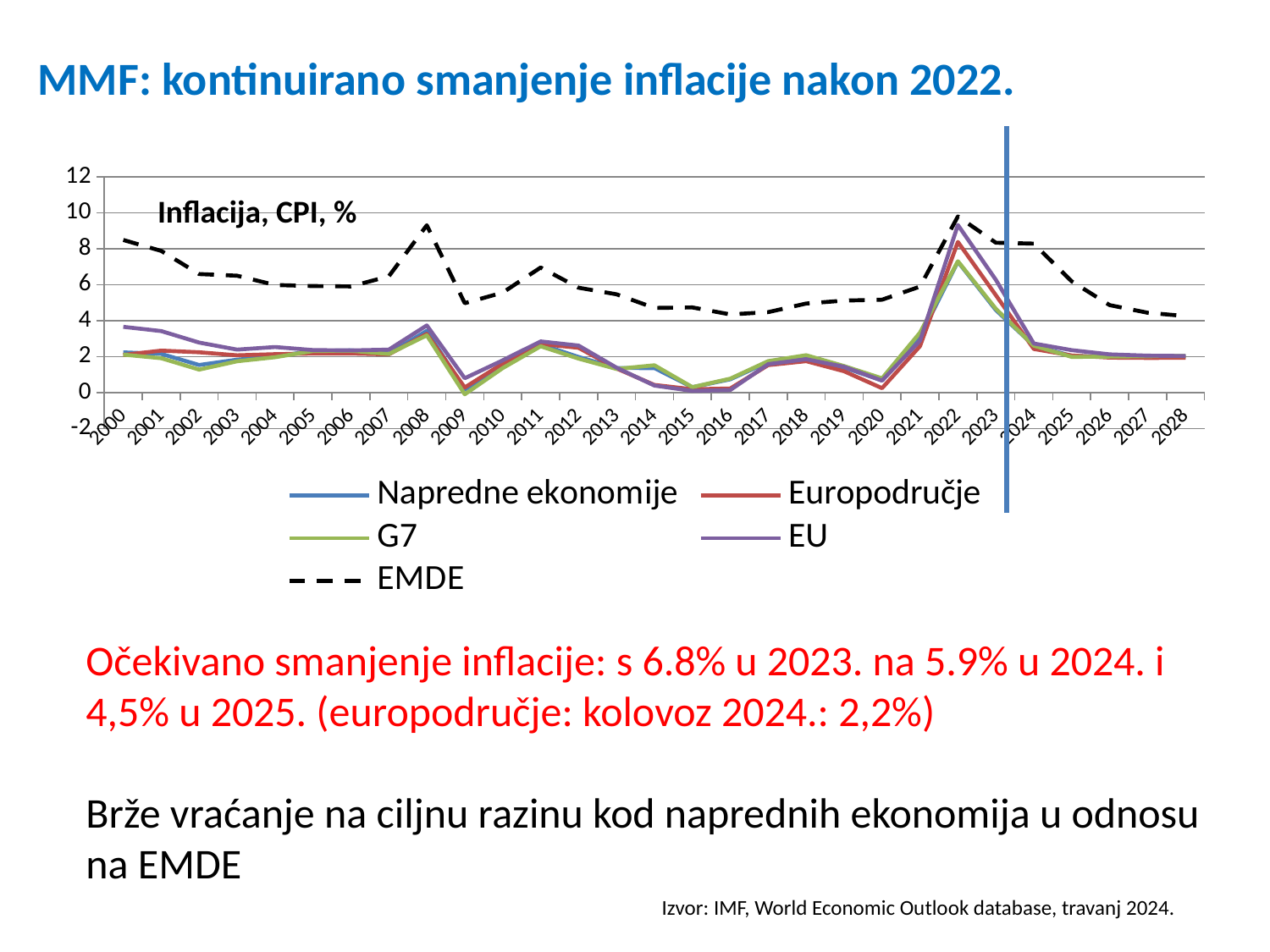
Is the value for EMDE in 2008 greater or less than 8? greater Which series is drawn with a dashed line? EMDE Is the value for EU in 2022 greater or less than 8? greater Do the values for Europodručje rise or fall from 2022 to 2025? fall What is the title printed inside the chart area? Inflacija, CPI, % Is the value for EMDE in 2016 greater or less than 6? less How many series does the chart legend list? 5 How many years are shown along the x axis of the chart? 29 What kind of chart is shown on the slide? line chart In which year does the EU series reach its highest value? 2022 In 2000, which series has the higher value, EMDE or EU? EMDE